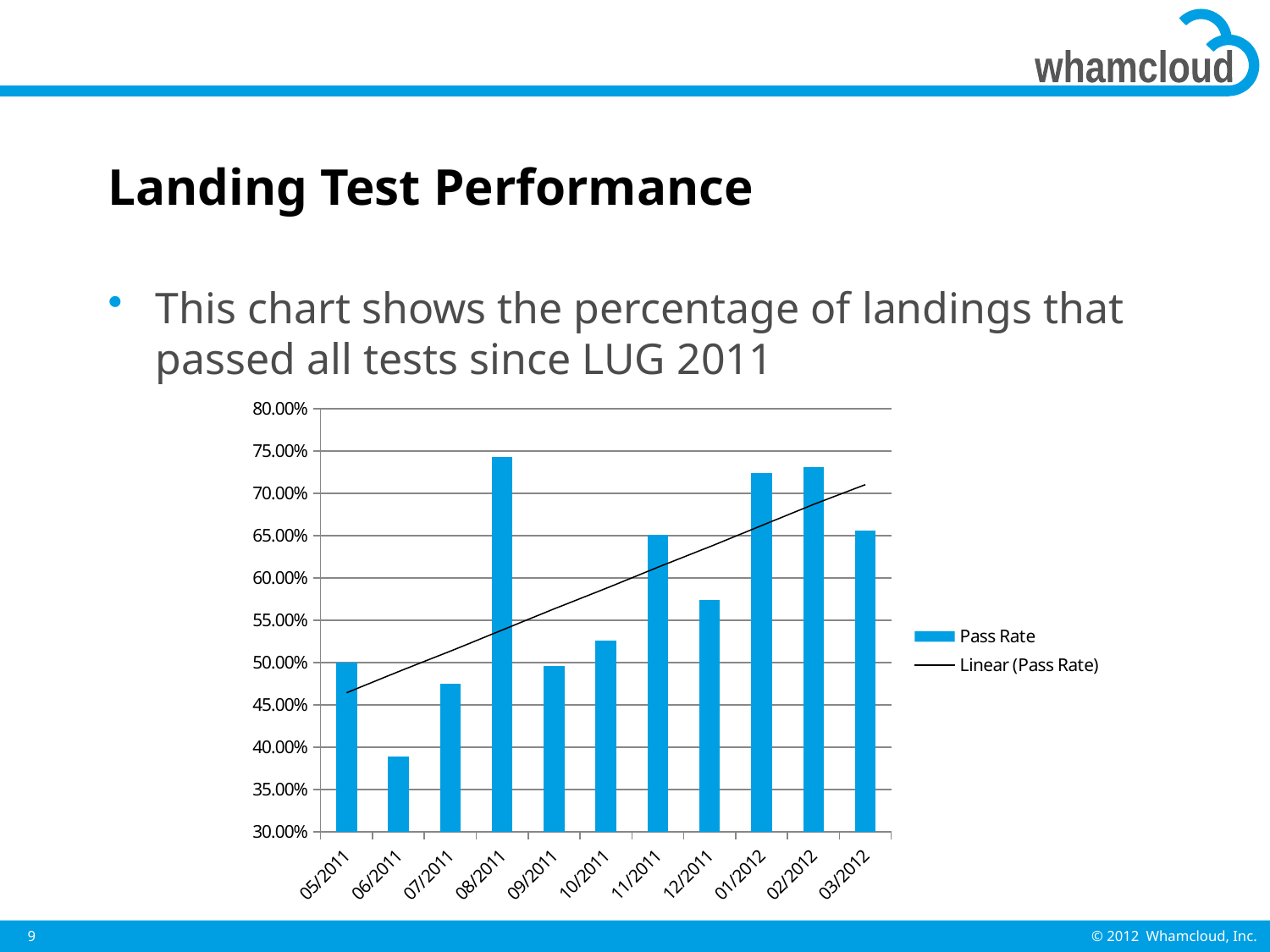
What kind of chart is shown on the slide? bar chart Is the pass rate for 11/2011 greater or less than 60.00%? greater Which has the higher pass rate, 12/2011 or 01/2012? 01/2012 Is the pass rate for 07/2011 greater or less than 50.00%? less Which month has the highest pass rate? 08/2011 Is the pass rate for 08/2011 greater or less than 70.00%? greater Which month has the lowest pass rate? 06/2011 What is the name of the line series shown in the chart's legend? Linear (Pass Rate) How many entries does the chart's legend list? 2 How many months are plotted on the x axis of the chart? 11 Does the linear trend line for the pass rate rise or fall from 05/2011 to 03/2012? rise